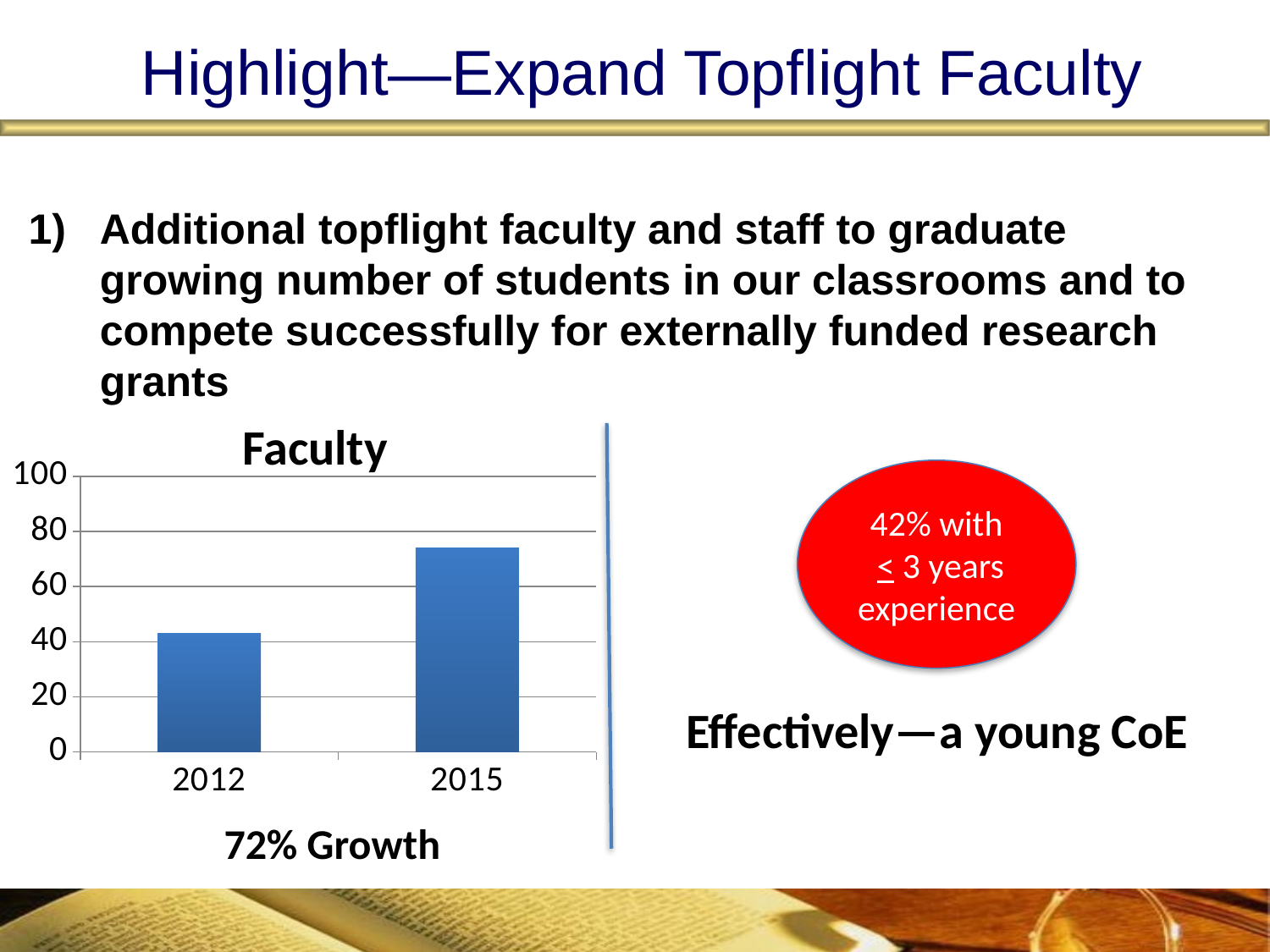
Is the value for 2015 greater or less than 60? greater Which year has the higher faculty value in the chart? 2015 Is the value for 2012 greater or less than 20? greater What growth percentage is printed below the Faculty chart? 72% Growth Do the faculty values rise or fall from 2012 to 2015? rise Is the value for 2012 greater or less than 60? less What type of chart is shown on the slide? bar chart What is the title of the chart? Faculty Is the bar for 2012 larger or smaller than the bar for 2015? smaller How many categories are shown on the x axis of the Faculty chart? 2 Which year has the lower faculty value in the chart? 2012